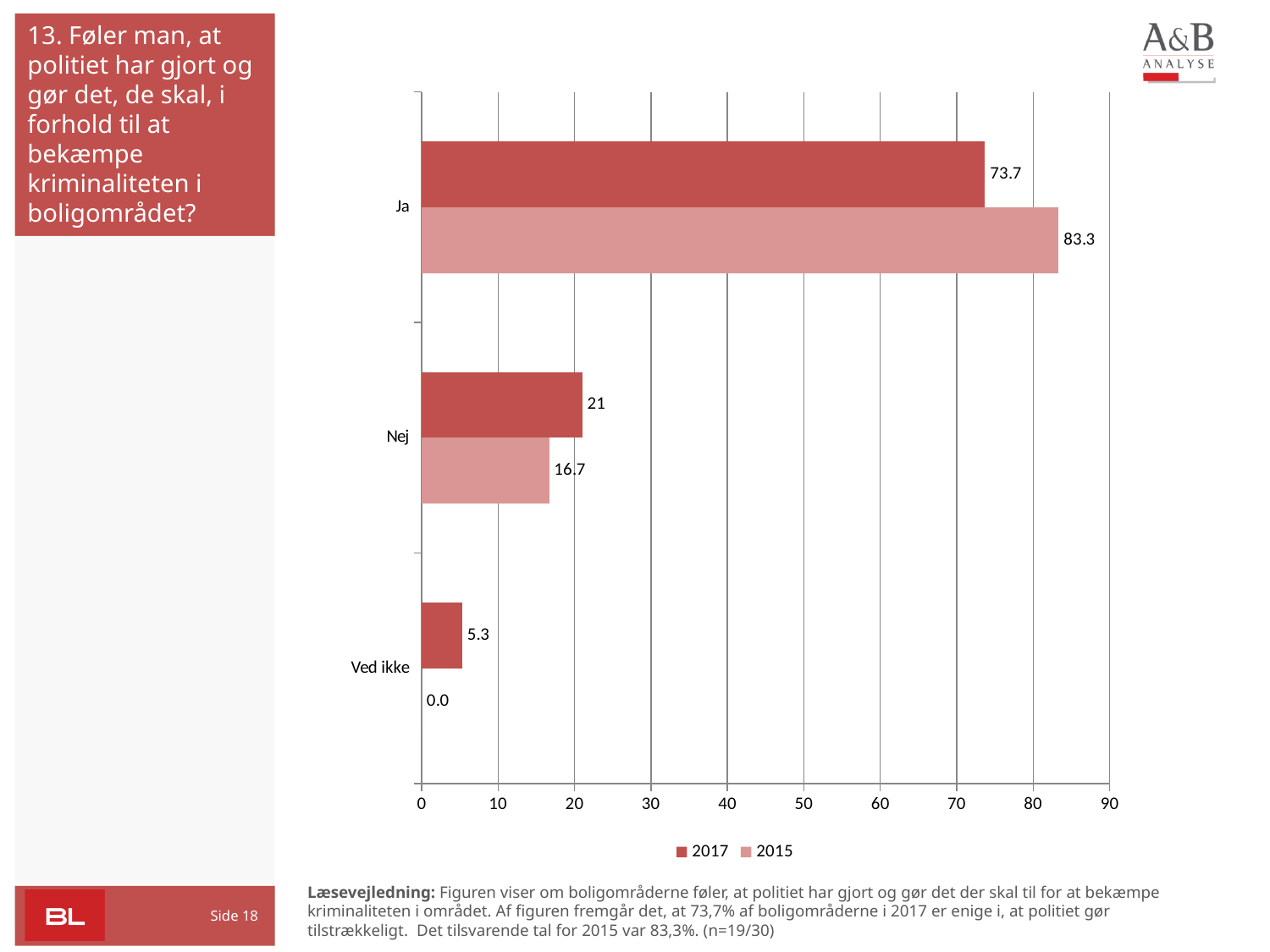
What is the difference between the 2015 and 2017 values for "Ja"? 9.6 Which category has the highest value in the 2015 series? Ja What is the value for "Nej" in the 2017 series? 21 For "Nej", which series has the larger value, 2017 or 2015? 2017 How many categories are shown on the chart? 3 How many series does the legend list? 2 What kind of chart is shown on the slide? Bar chart What is the value for "Ja" in the 2015 series? 83.3 Is the 2017 value for "Ja" greater or less than 70? greater What is the value for "Ja" in the 2017 series? 73.7 What is the value for "Ved ikke" in the 2015 series? 0.0 Which category has the lowest value in the 2017 series? Ved ikke